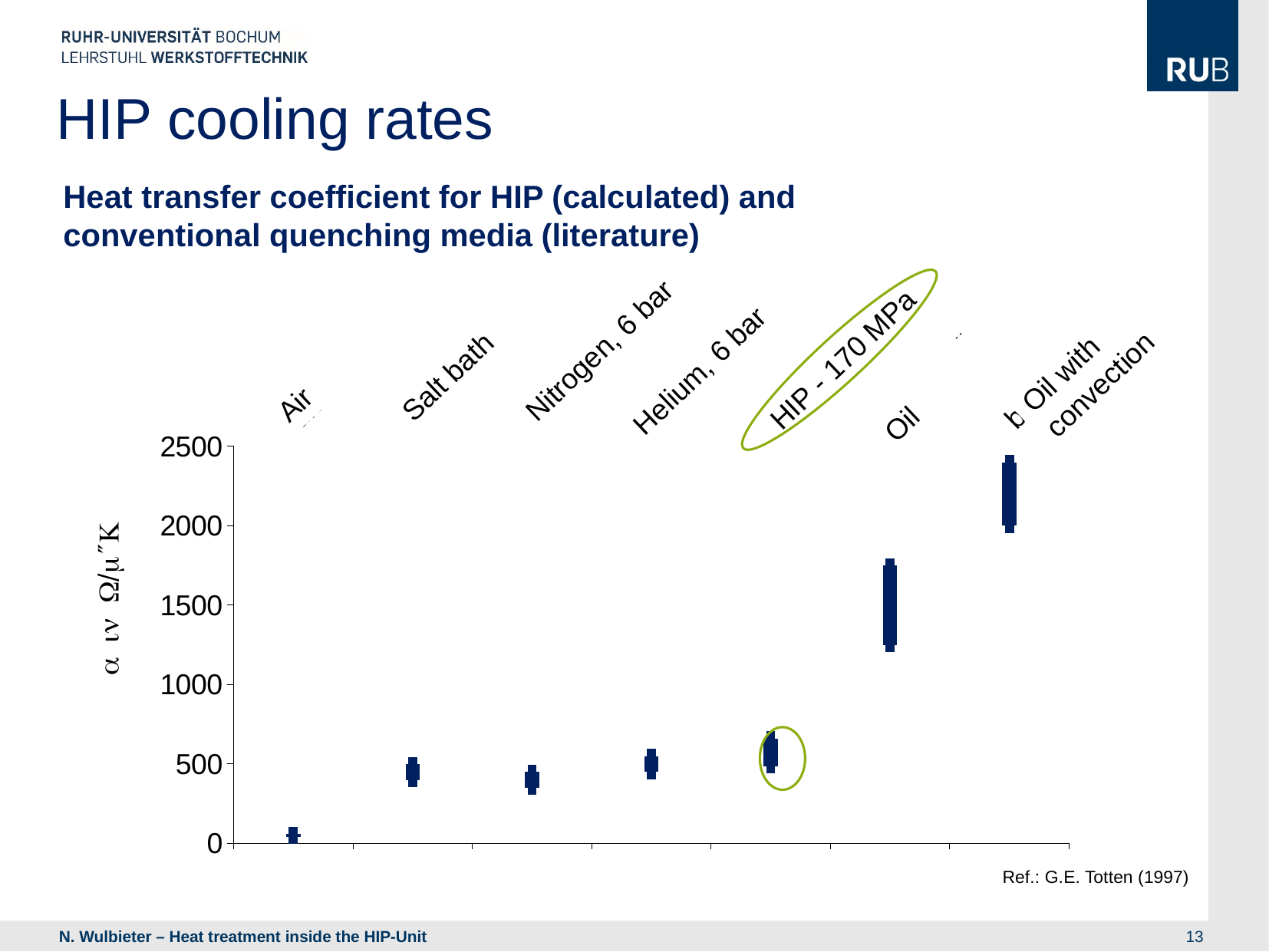
What is the highest value shown on the vertical axis of the chart? 2500 Is the value for Oil greater or less than 2000? less Is the value for Oil greater or less than 1000? greater Which has the larger heat transfer coefficient, Oil with convection or Oil? Oil with convection Which category on the chart is highlighted with a green ellipse? HIP - 170 MPa Which has the larger heat transfer coefficient, Salt bath or Air? Salt bath Which category has the highest heat transfer coefficient on the chart? Oil with convection Which category has the lowest heat transfer coefficient on the chart? Air Is the value for Oil with convection greater or less than 1500? greater Which has the larger heat transfer coefficient, Oil or Air? Oil How many quenching media categories are plotted on the chart? 7